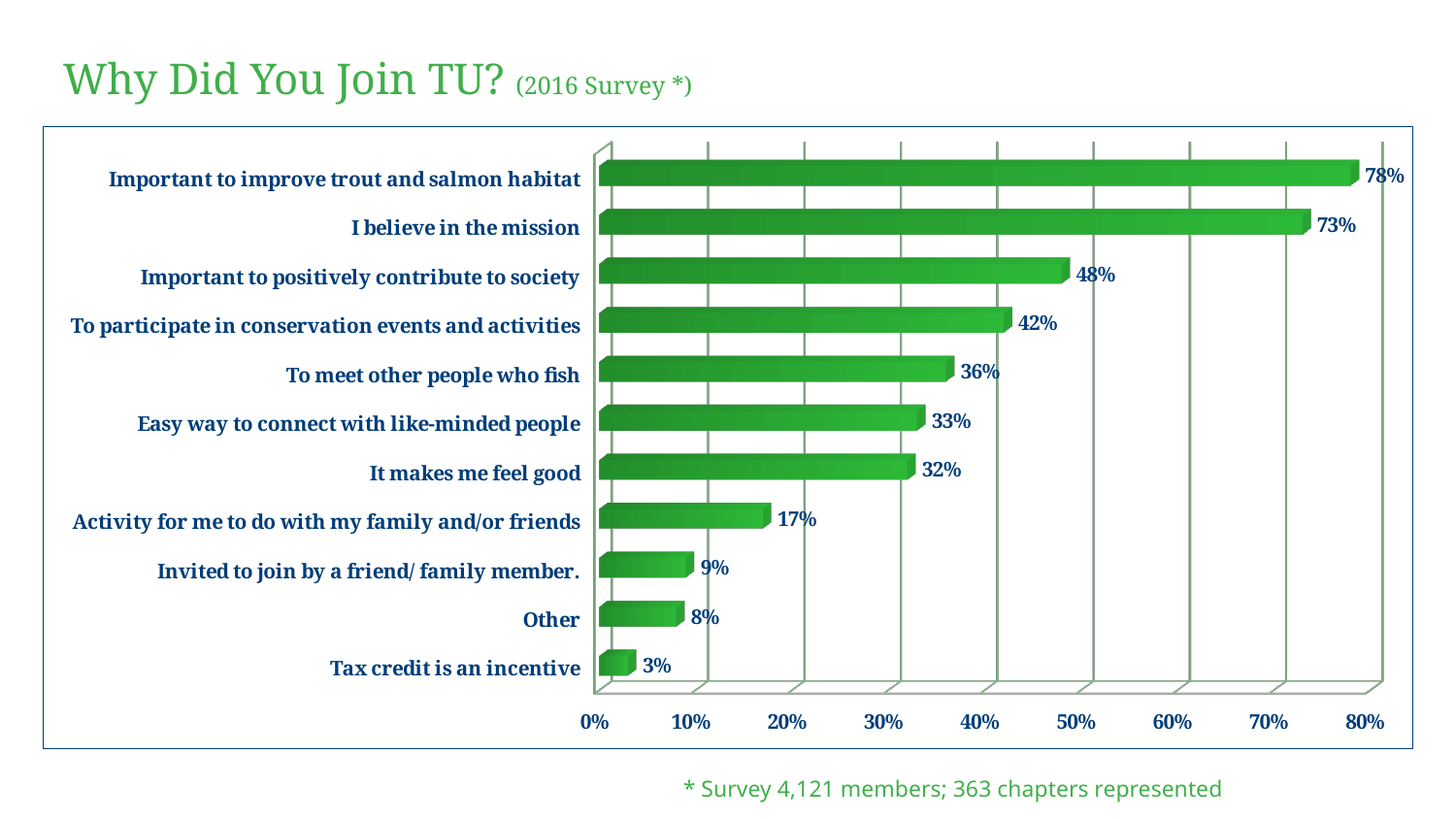
What is the difference in percentage points between 'Important to improve trout and salmon habitat' and 'I believe in the mission'? 5 percentage points What percentage of respondents said 'Important to improve trout and salmon habitat' was a reason they joined TU? 78% What type of chart is shown on the slide? Bar chart What is the title of the chart on the slide? Why Did You Join TU? (2016 Survey *) Which is larger: 'Easy way to connect with like-minded people' or 'It makes me feel good'? Easy way to connect with like-minded people What is the value for 'I believe in the mission'? 73% Which reason for joining TU has the lowest percentage? Tax credit is an incentive What percentage is shown for 'To meet other people who fish'? 36% How many reasons for joining TU are listed in the chart? 11 What is the value for 'Tax credit is an incentive'? 3% Which reason for joining TU has the highest percentage? Important to improve trout and salmon habitat What is the difference between 'Important to positively contribute to society' and 'To participate in conservation events and activities'? 6 percentage points